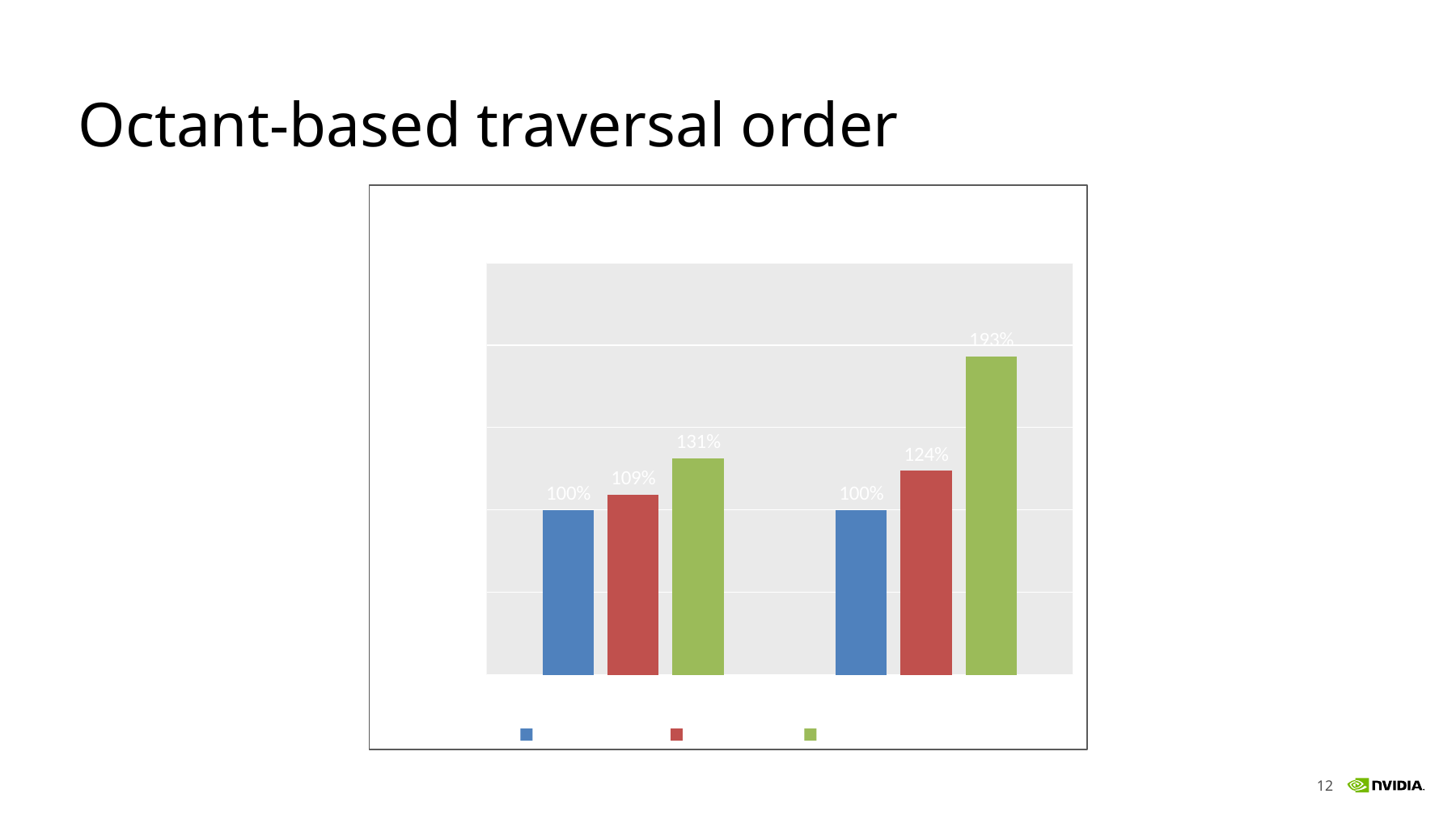
What is the value labelled on the green bar in the right-hand group? 193% What kind of chart is shown on the slide? bar chart What is the value labelled on the red bar in the left-hand group? 109% What is the value labelled on the red bar in the right-hand group? 124% How many colour entries does the legend below the chart show? 3 Which is larger: the red bar in the left-hand group or the red bar in the right-hand group? the red bar in the right-hand group Which bar has the highest value in the chart? the green bar in the right-hand group What is the difference between the green bar in the right-hand group and the green bar in the left-hand group? 62% What is the value labelled on the blue bar in each group? 100% What is the difference between the red bar and the blue bar in the right-hand group? 24% What is the value labelled on the green bar in the left-hand group? 131% How many groups of bars are plotted in the chart? 2